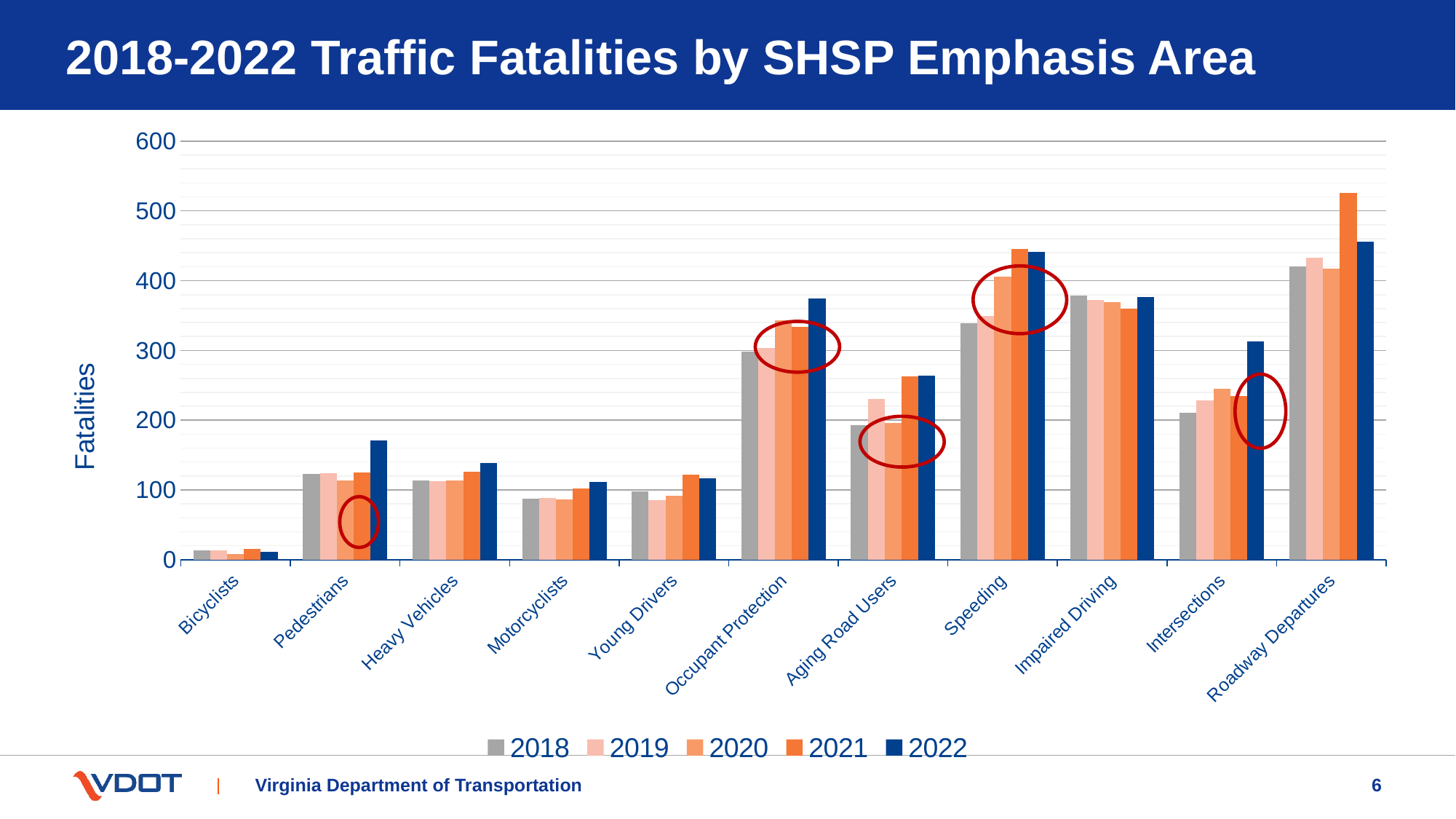
Which emphasis area has the lowest fatalities across all years? Bicyclists How many series does the legend list? 5 Which emphasis area has the highest 2021 fatalities bar? Roadway Departures Is the 2022 value for Intersections greater or less than 300? greater Is the 2022 value for Pedestrians greater or less than 150? greater What is the label on the vertical axis? Fatalities What kind of chart is shown on the slide? bar chart Is the 2021 value for Roadway Departures greater or less than 500? greater For Pedestrians, which year has the highest bar? 2022 How many emphasis area categories are shown on the x axis? 11 For Aging Road Users, which year has the larger value: 2019 or 2020? 2019 For 2018, which is larger: Speeding or Impaired Driving? Impaired Driving